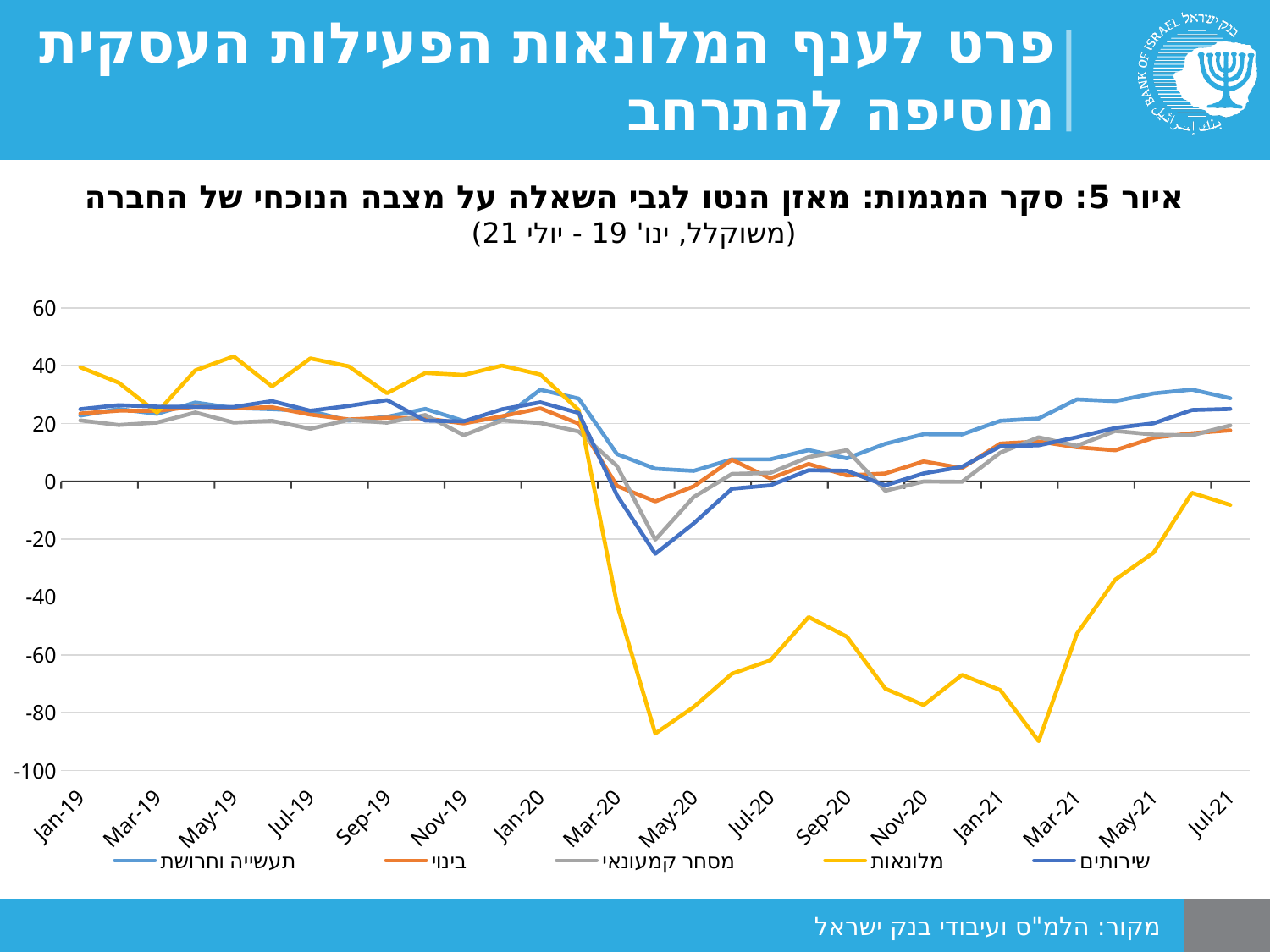
Which series has the lowest value in Mar-21? מלונאות How many month labels are shown along the x axis? 16 What kind of chart is shown on the slide? line chart Does the מלונאות series rise or fall between Mar-21 and Jun-21? rise Is the value for תעשייה וחרושת in Jul-21 greater or less than 20? greater How many series does the legend list? 5 Is the value for שירותים in Apr-20 greater or less than 0? less What is the lowest value shown on the y axis? -100 Which series has the lowest value in May-20? מלונאות Is the value for מלונאות in Jul-21 greater or less than 0? less In May-20, which is larger: the value for מלונאות or the value for תעשייה וחרושת? תעשייה וחרושת